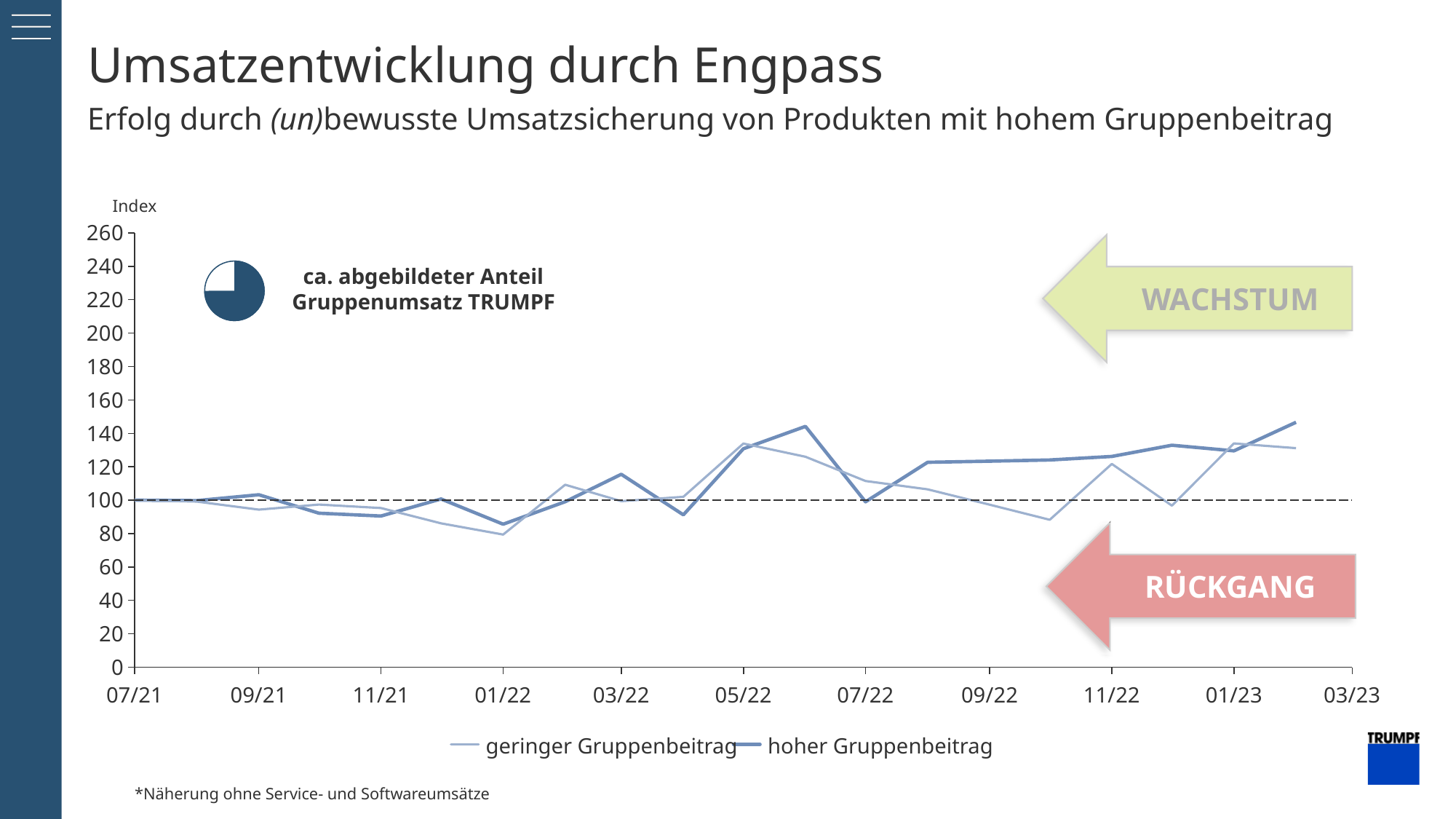
At which month does the geringer Gruppenbeitrag series reach its lowest value? 01/22 Is the value for hoher Gruppenbeitrag at 02/23 greater or less than 140? greater Is the value for hoher Gruppenbeitrag at 04/22 greater or less than 100? less What are the two series named in the chart legend? geringer Gruppenbeitrag and hoher Gruppenbeitrag At 02/23, which series has the higher value, geringer Gruppenbeitrag or hoher Gruppenbeitrag? hoher Gruppenbeitrag Is the value for geringer Gruppenbeitrag at 10/22 greater or less than 100? less Does the hoher Gruppenbeitrag series rise or fall from 07/22 to 02/23? rise At 10/22, which series has the higher value, geringer Gruppenbeitrag or hoher Gruppenbeitrag? hoher Gruppenbeitrag What is the label on the vertical axis of the chart? Index How many series does the chart legend list? 2 What kind of chart is shown on the slide? line chart